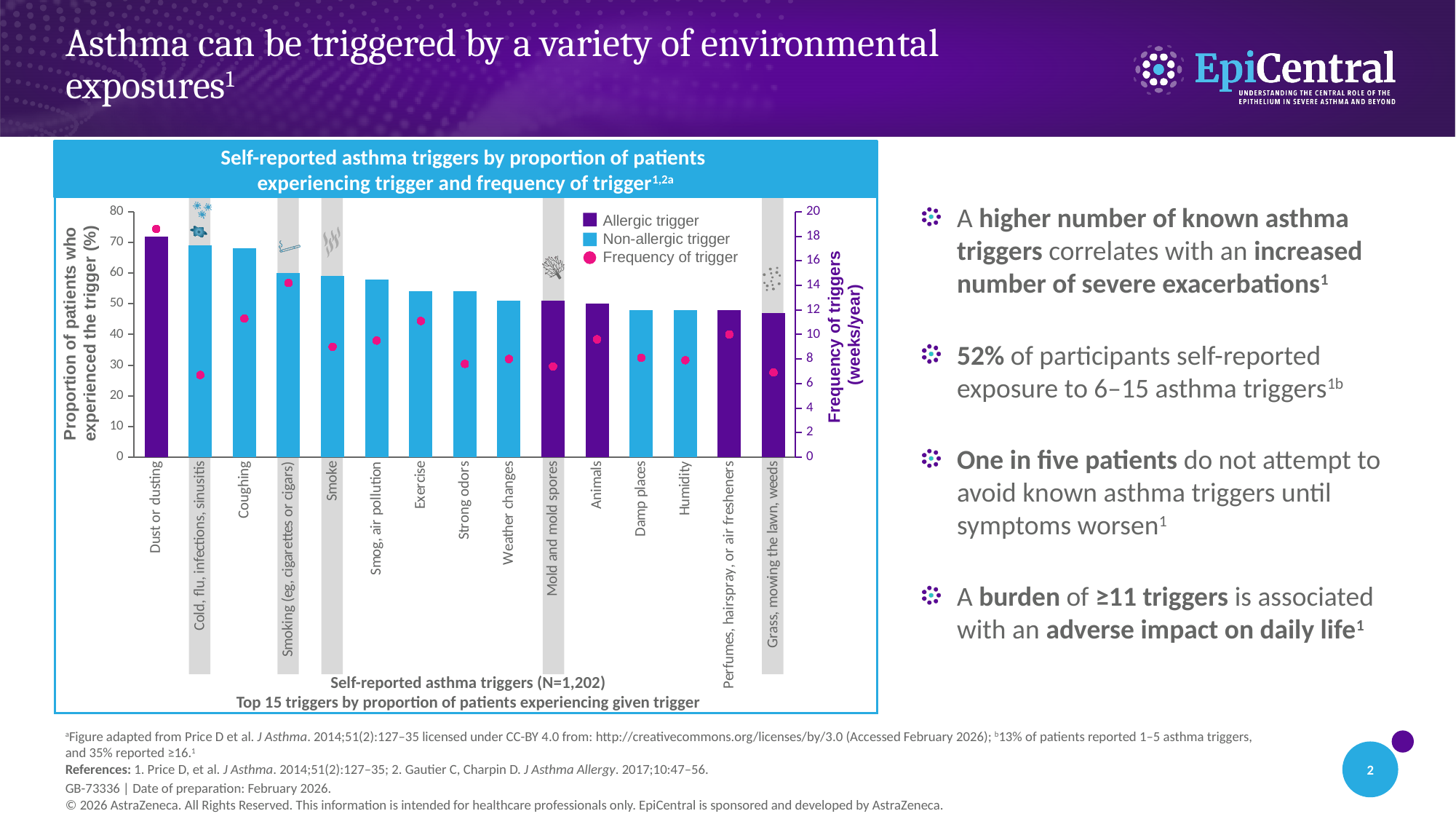
Which colour represents an allergic trigger in the chart? Purple How many entries does the chart legend list? 3 How many self-reported asthma triggers are shown on the x axis? 15 Is the proportion of patients for Coughing greater or less than 60%? greater Is the proportion of patients for Grass, mowing the lawn, weeds greater or less than 50%? less Which trigger has the highest proportion of patients who experienced it? Dust or dusting Is the frequency of trigger for Dust or dusting greater or less than 16 weeks/year? greater What kind of chart is used to show the proportion of patients experiencing each trigger? Bar chart Do the bar heights rise or fall moving from left to right along the x axis? Fall Which has a higher proportion of patients: Coughing or Exercise? Coughing